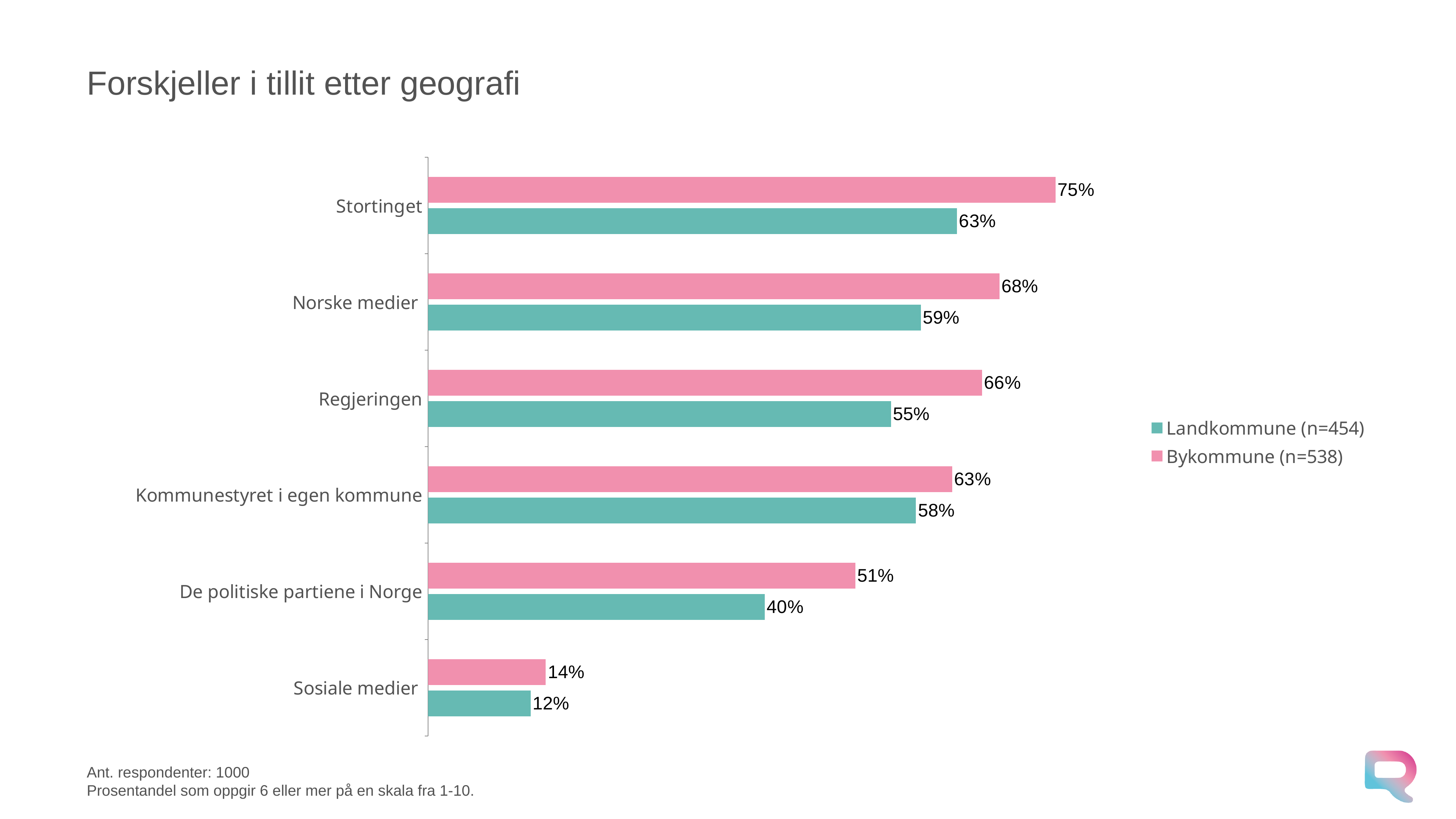
What is the value for Bykommune (n=538) for Stortinget? 75% What is the title of the chart? Forskjeller i tillit etter geografi What kind of chart is shown on the slide? Bar chart What is the difference between the Bykommune (n=538) and Landkommune (n=454) values for Stortinget? 12% What is the value for Landkommune (n=454) for Norske medier? 59% What is the value for Landkommune (n=454) for De politiske partiene i Norge? 40% Which category has the highest value for Bykommune (n=538)? Stortinget Which category has the lowest value for Landkommune (n=454)? Sosiale medier Which is larger for Regjeringen: the Landkommune (n=454) value or the Bykommune (n=538) value? Bykommune (n=538) What is the difference between the Bykommune (n=538) and Landkommune (n=454) values for De politiske partiene i Norge? 11% How many series does the legend list? 2 How many categories are shown on the chart? 6